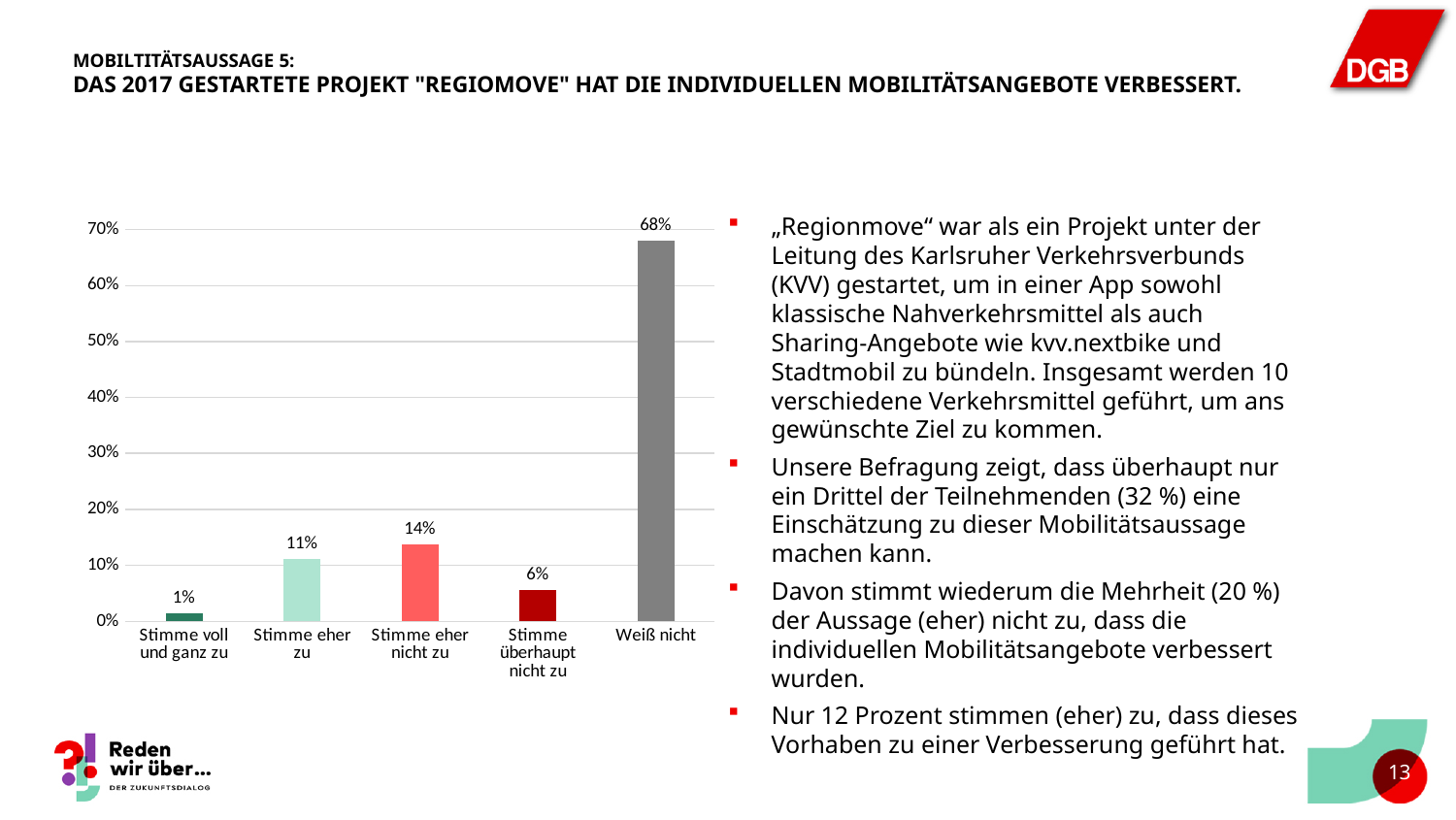
What is the value for "Stimme voll und ganz zu"? 1% Which category has the highest value? Weiß nicht What is the value for "Stimme überhaupt nicht zu"? 6% Which is larger, "Stimme eher zu" or "Stimme überhaupt nicht zu"? Stimme eher zu What is the difference between "Stimme eher nicht zu" and "Stimme eher zu"? 3% How many categories are shown in the chart? 5 Which category has the lowest value? Stimme voll und ganz zu Is the value for "Weiß nicht" greater or less than 60%? greater What is the value for "Weiß nicht"? 68% What is the value for "Stimme eher nicht zu"? 14% What is the combined value of "Stimme voll und ganz zu" and "Stimme eher zu"? 12% What kind of chart is shown on the slide? Bar chart